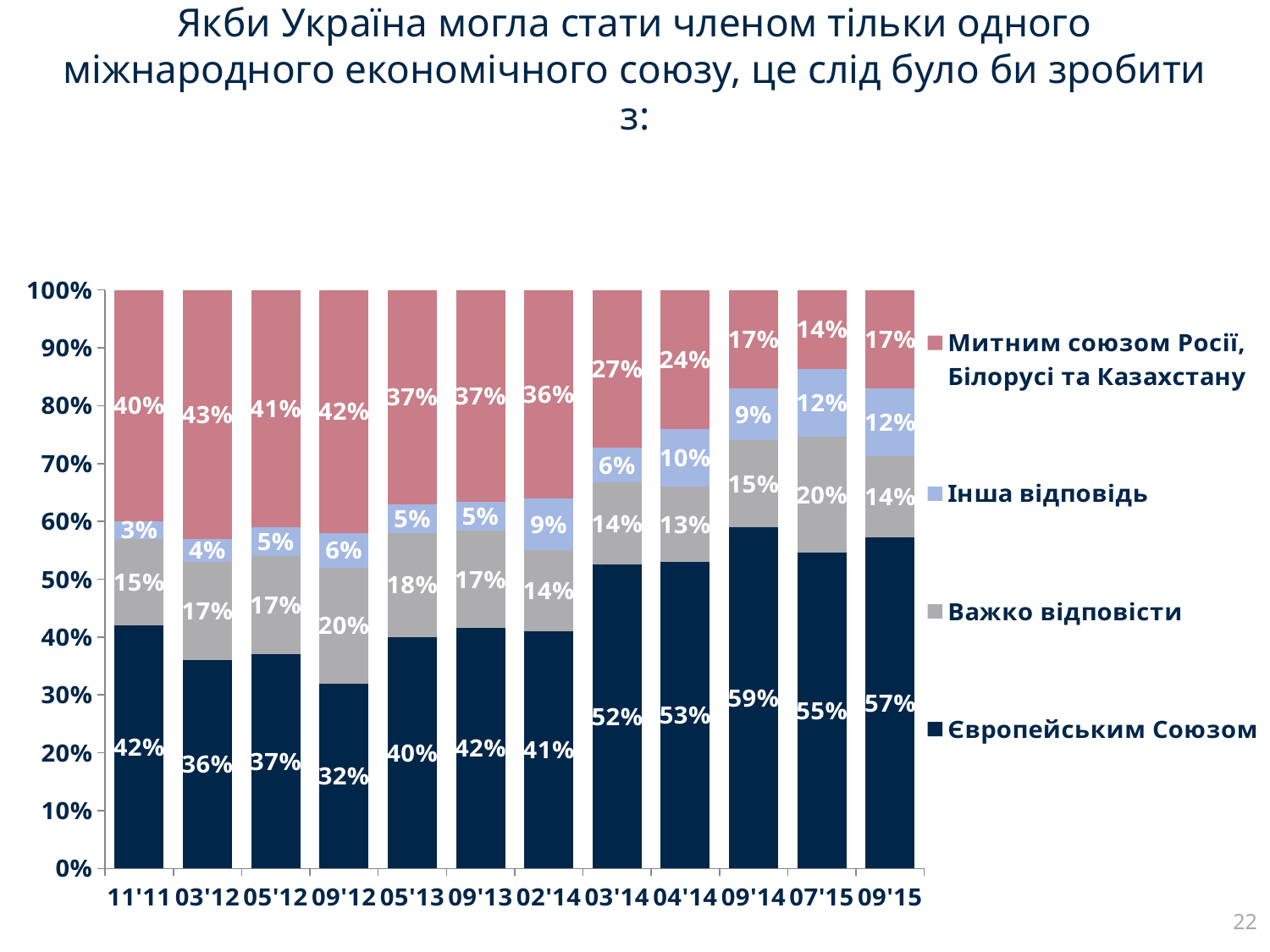
Which is larger at 02'14: the value for Європейським Союзом or for Митним союзом Росії, Білорусі та Казахстану? Європейським Союзом What is the value for Інша відповідь at 04'14? 10% How many series does the legend list? 4 What type of chart is shown on the slide? stacked bar chart At which time point is the value for Митним союзом Росії, Білорусі та Казахстану the highest? 03'12 What is the difference between the Європейським Союзом values at 09'15 and 11'11? 15% What is the value for Митним союзом Росії, Білорусі та Казахстану at 03'12? 43% What is the value for Європейським Союзом at 09'14? 59% How many time points are shown on the x axis? 12 Which colour represents Важко відповісти in the chart? grey Does the value for Митним союзом Росії, Білорусі та Казахстану generally rise or fall from 11'11 to 09'15? fall At which time point is the value for Європейським Союзом the lowest? 09'12